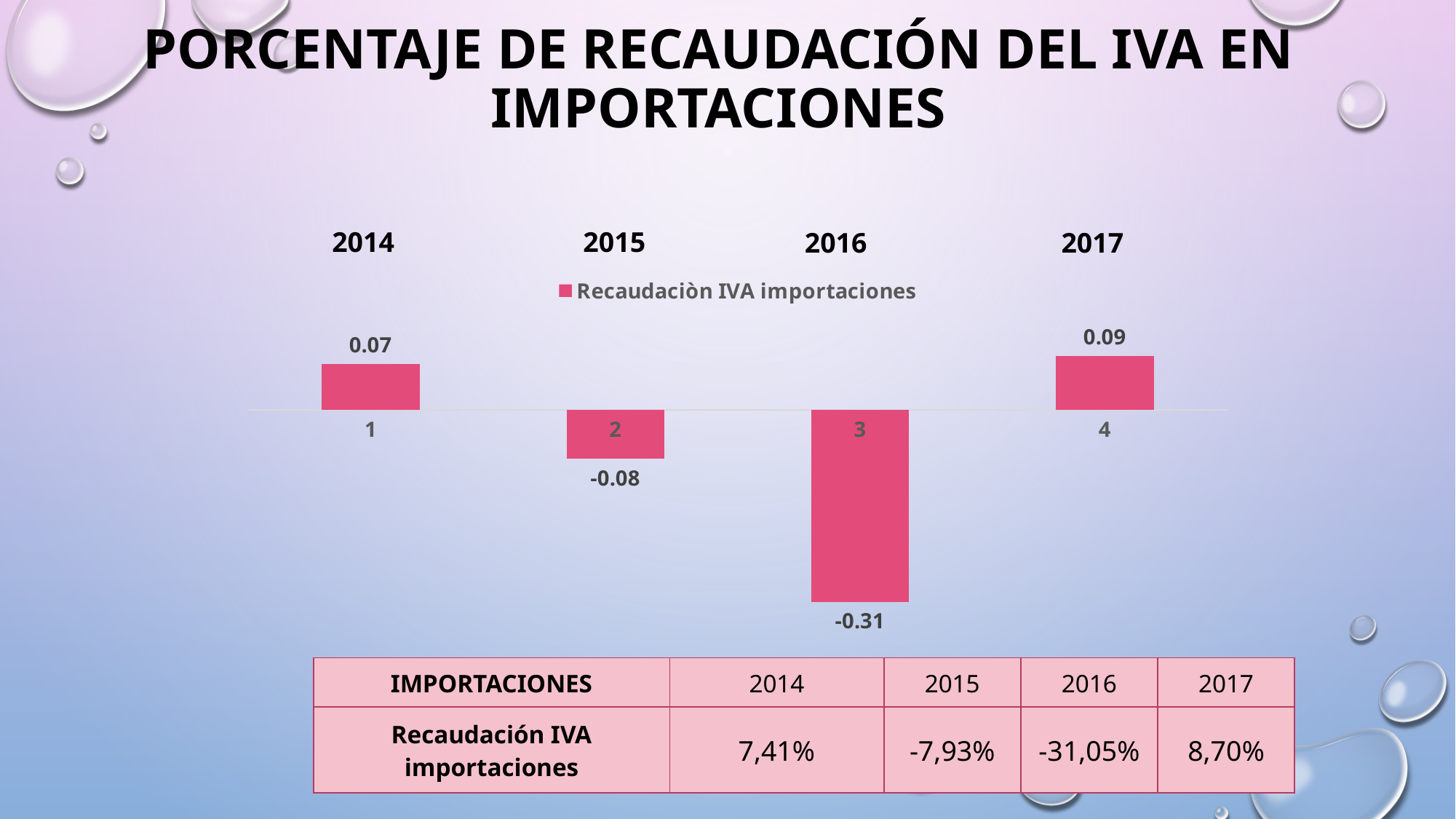
What is the difference between the 2014 value and the 2015 value? 0.15 What is the data label on the bar for 2015? -0.08 What is the data label on the bar for 2014? 0.07 What is the data label on the bar for 2017? 0.09 How many bars are plotted in the chart? 4 What type of chart is shown on the slide? Bar chart Which year has the highest value in the chart? 2017 What series name does the chart legend show? Recaudaciòn IVA importaciones What is the data label on the bar for 2016? -0.31 What is the difference between the 2017 value and the 2014 value? 0.02 Which year has the lowest value in the chart? 2016 Which is larger, the value for 2014 or the value for 2017? 2017